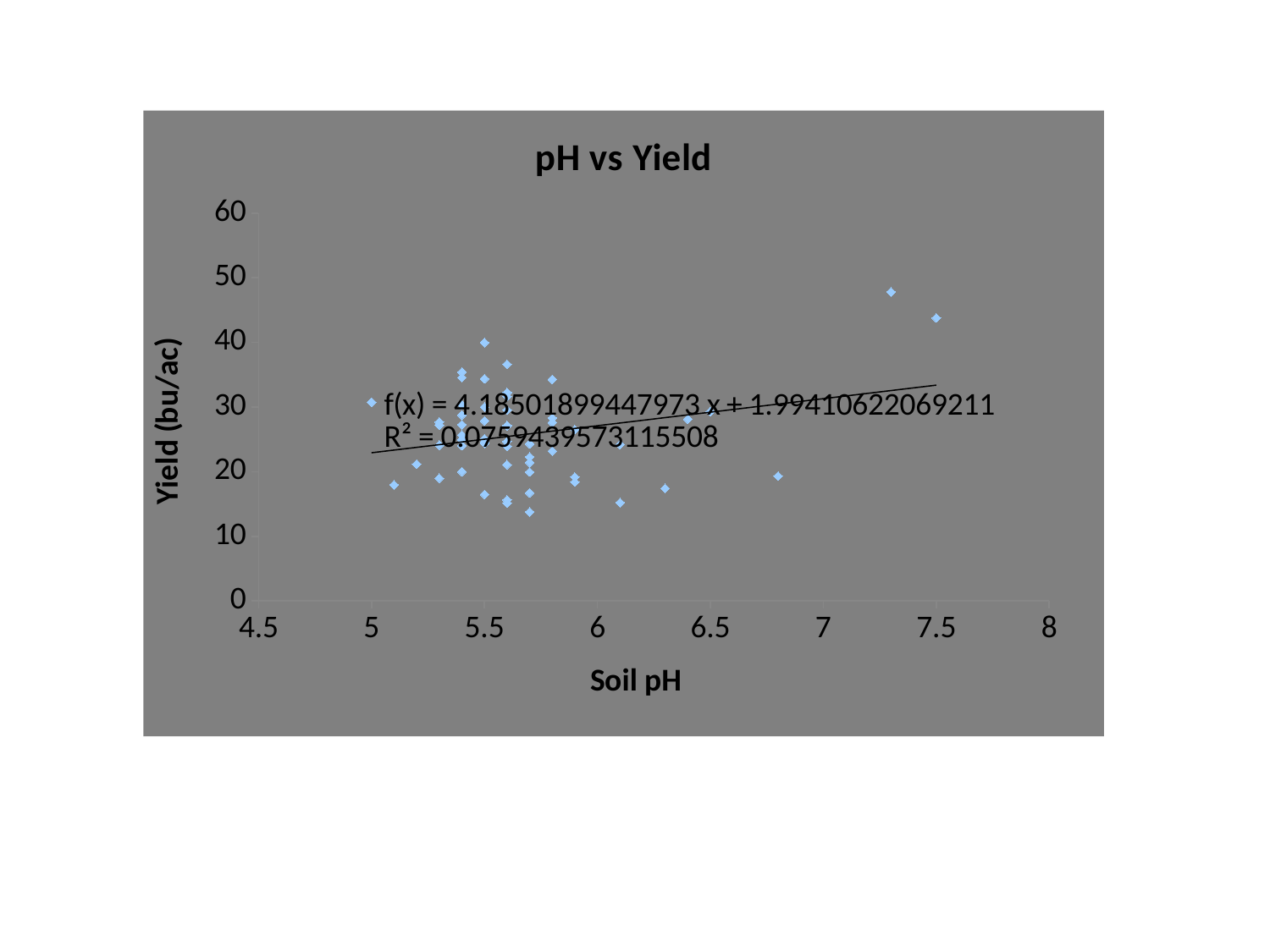
What kind of chart is shown on the slide? scatter plot What R² value is printed on the chart? 0.0759439573115508 Is the yield for the point at soil pH 7.5 greater or less than 40? greater Is the yield for the point at soil pH 6.3 greater or less than 20? less Which has the higher yield: the point at soil pH 6.8 or the point at soil pH 6.4? the point at soil pH 6.4 Is the yield for the point at soil pH 7.3 greater or less than 40? greater What is the title of the chart? pH vs Yield Which has the higher yield: the point at soil pH 7.3 or the point at soil pH 7.5? the point at soil pH 7.3 Does the fitted trendline rise or fall as soil pH increases? rises